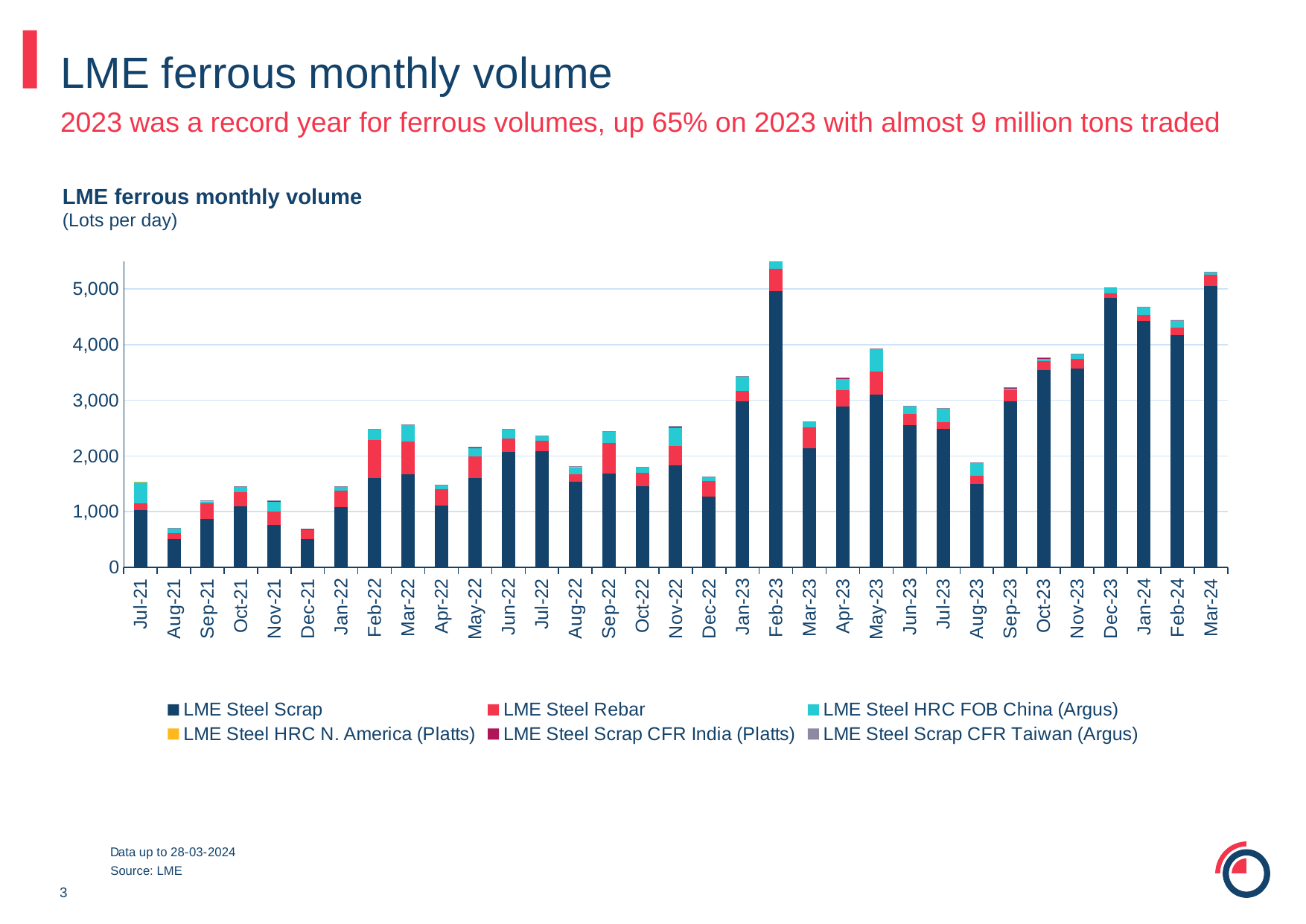
Is the total value for Aug-21 greater or less than 1,000? less What unit is the y axis measured in, according to the chart subtitle? Lots per day Which month has the highest total volume? Feb-23 How many months are plotted along the x axis? 33 How many series does the legend list? 6 Is the total value for Feb-23 greater or less than 5,000? greater Is the total value for Aug-23 greater or less than 2,000? less Which series is shown in dark blue in the legend? LME Steel Scrap Which has the larger total volume, Dec-22 or Jan-23? Jan-23 Overall, do the monthly volumes rise or fall from Jul-21 to Mar-24? Rise What kind of chart is shown on the slide? Stacked bar chart